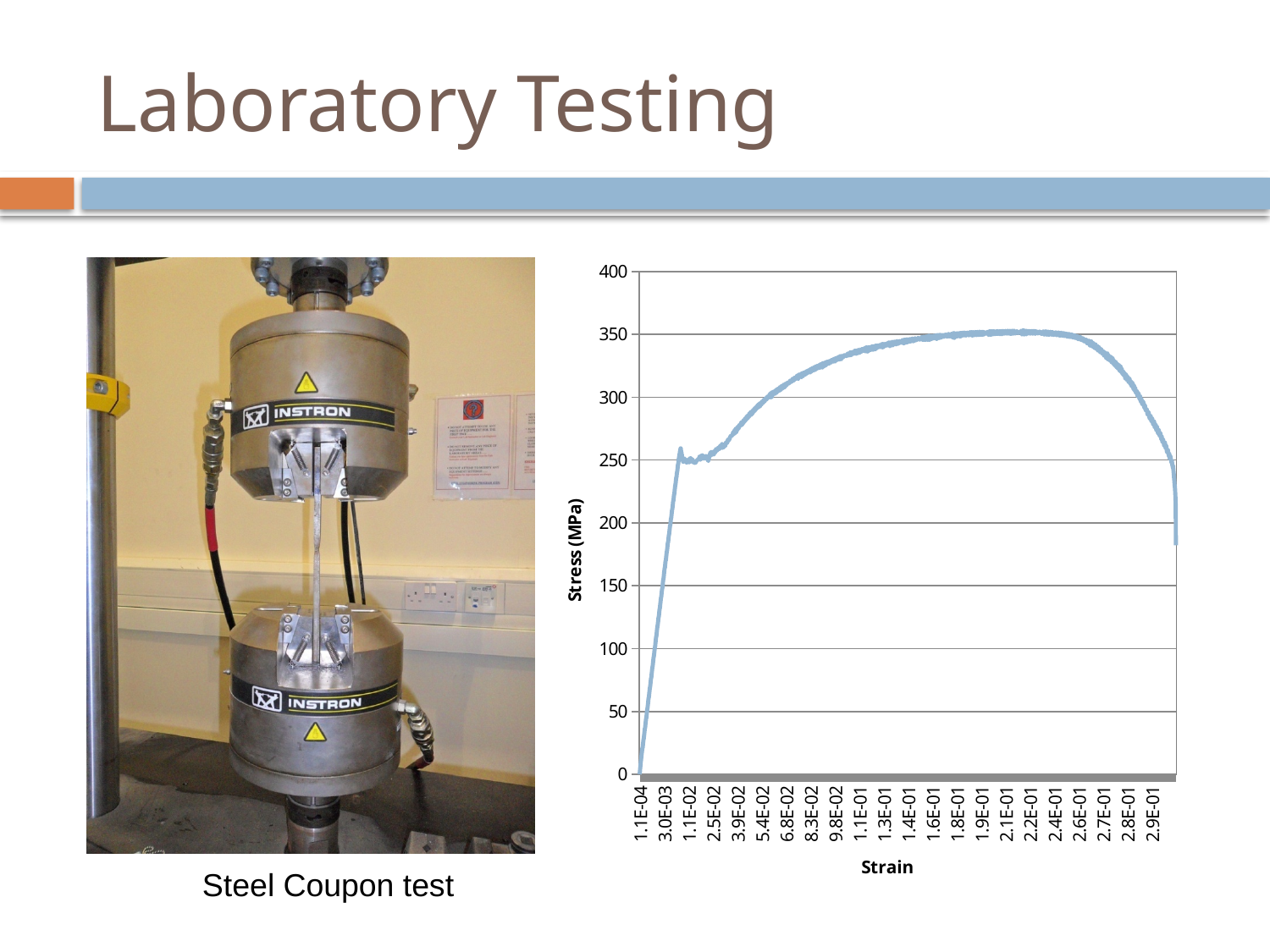
Is the stress at the final strain of 2.9E-01 greater or less than 300? less Which has the higher stress: a strain of 1.6E-01 or a strain of 2.9E-01? 1.6E-01 What is the title of the vertical axis of the chart? Stress (MPa) Is the peak stress reached on the chart greater or less than 300? greater Is the stress at a strain of 1.6E-01 greater or less than 300? greater What is the title of the horizontal axis of the chart? Strain What is the highest value shown on the vertical axis of the chart? 400 What kind of chart is shown on the slide? line chart Does the stress rise or fall as strain increases from 1.1E-04 to 1.1E-02? rise Does the stress rise or fall as strain increases from 2.6E-01 to 2.9E-01? fall